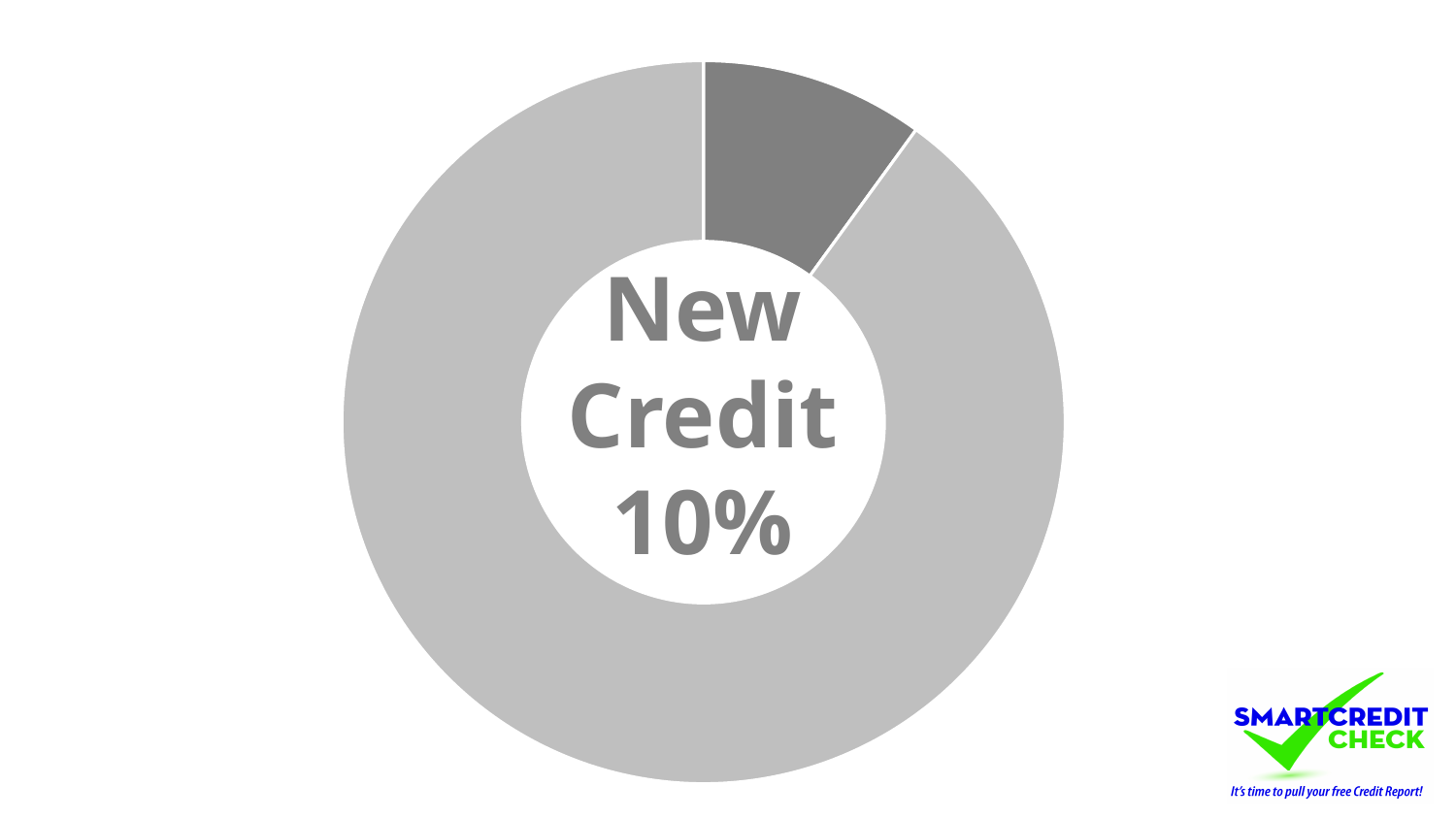
What share of the doughnut chart does New Credit represent? 10% What text is printed in the centre of the doughnut chart? New Credit 10% What kind of chart is shown on the slide? Doughnut chart How many slices does the doughnut chart have? 2 Is the share for New Credit greater or less than 50%? less Which slice of the doughnut chart is the smallest? New Credit What value is printed in the centre of the doughnut chart for New Credit? 10% What colour is the New Credit slice of the doughnut chart? Dark grey Which slice of the doughnut chart is larger, the dark grey New Credit slice or the light grey remainder? The light grey remainder